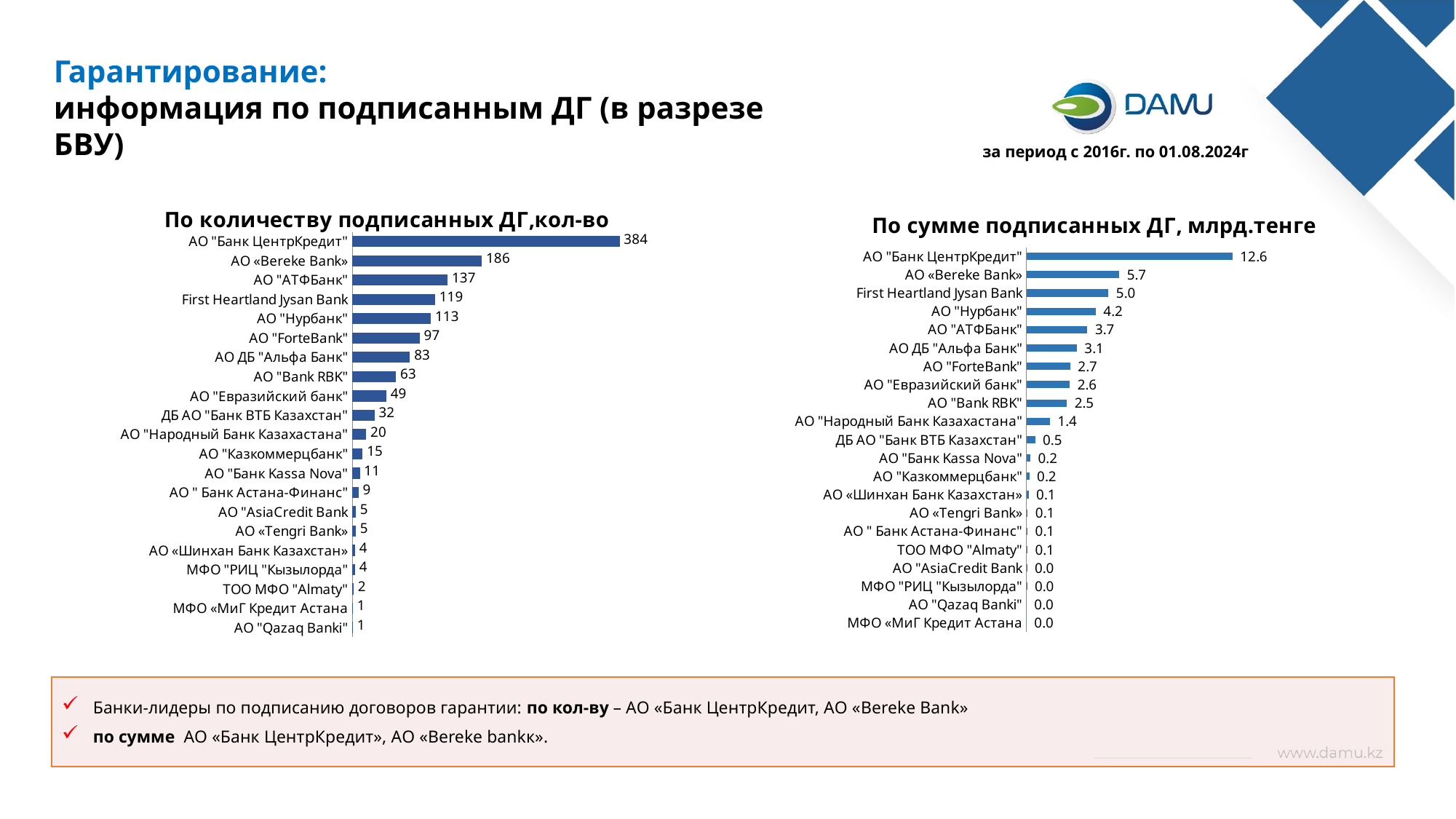
In the chart "По сумме подписанных ДГ, млрд.тенге", what is the value for АО ДБ "Альфа Банк"? 3.1 In the chart "По сумме подписанных ДГ, млрд.тенге", what is the difference between АО «Bereke Bank» and First Heartland Jysan Bank? 0.7 In the chart "По количеству подписанных ДГ,кол-во", which bank has the highest value? АО "Банк ЦентрКредит" In the chart "По сумме подписанных ДГ, млрд.тенге", what is the value for АО "Народный Банк Казахастана"? 1.4 What type of chart is "По сумме подписанных ДГ, млрд.тенге"? Bar chart In the chart "По количеству подписанных ДГ,кол-во", what is the value for АО "Банк ЦентрКредит"? 384 In the chart "По количеству подписанных ДГ,кол-во", which is larger: АО "Нурбанк" or First Heartland Jysan Bank? First Heartland Jysan Bank In the chart "По сумме подписанных ДГ, млрд.тенге", which is larger: АО "Нурбанк" or АО "АТФБанк"? АО "Нурбанк" How many banks are listed in the chart "По количеству подписанных ДГ,кол-во"? 21 In the chart "По сумме подписанных ДГ, млрд.тенге", what is the value for АО "Банк ЦентрКредит"? 12.6 In the chart "По количеству подписанных ДГ,кол-во", what is the value for АО "ForteBank"? 97 In the chart "По количеству подписанных ДГ,кол-во", what is the difference between АО «Bereke Bank» and АО "АТФБанк"? 49